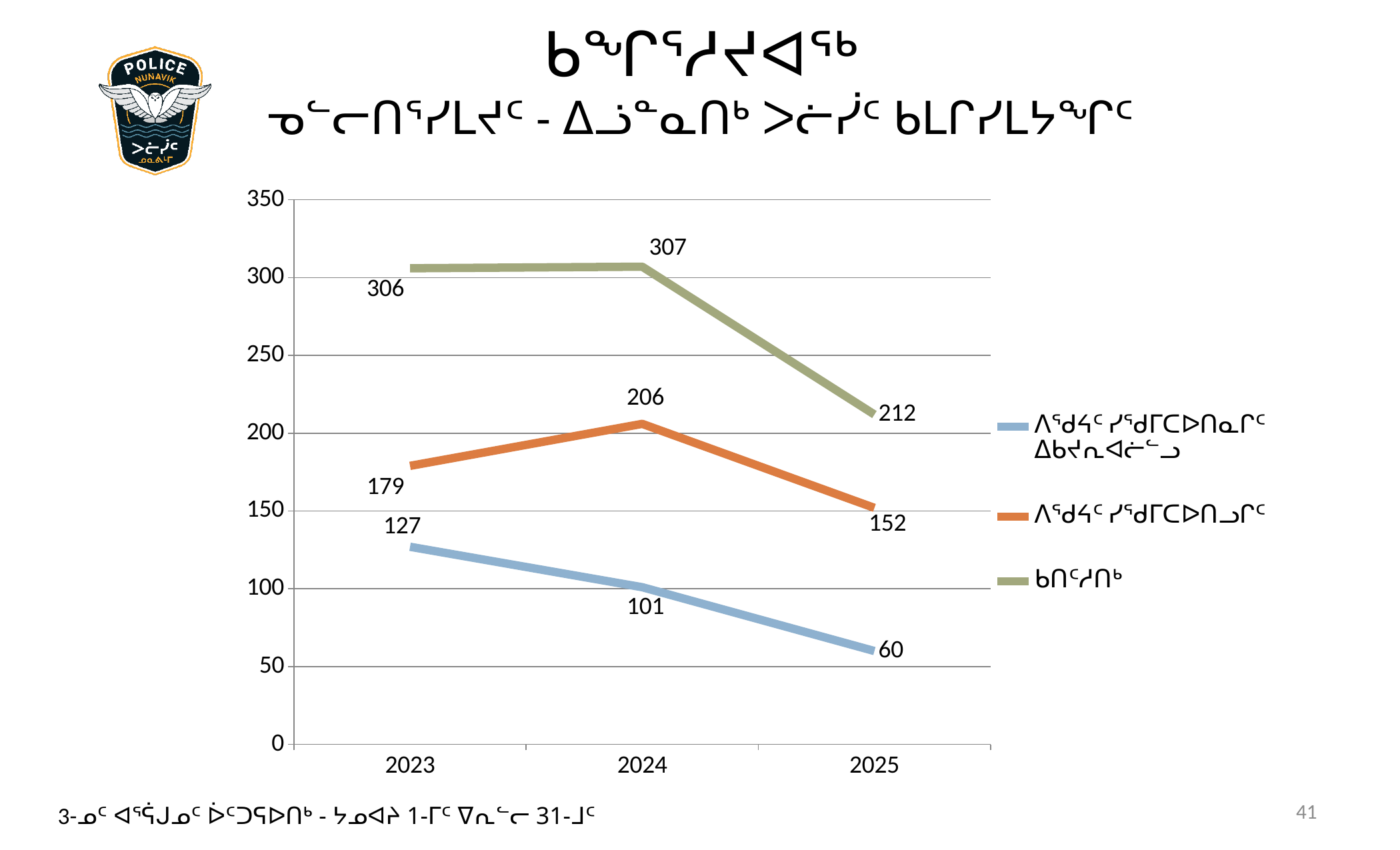
What is the value of the green line in 2024? 307 In which year is the blue line at its lowest value? 2025 Which is larger in 2025: the orange line's value or the blue line's value? the orange line (152) Does the blue line rise or fall from 2023 to 2025? fall What kind of chart is shown on the slide? line chart What is the value of the orange line in 2023? 179 Which colour is the third series in the legend? green What is the difference between the green line's value in 2024 and its value in 2025? 95 How many years are shown on the x axis? 3 How many series does the legend list? 3 In which year does the orange line reach its highest value? 2024 What is the value of the blue line in 2025? 60